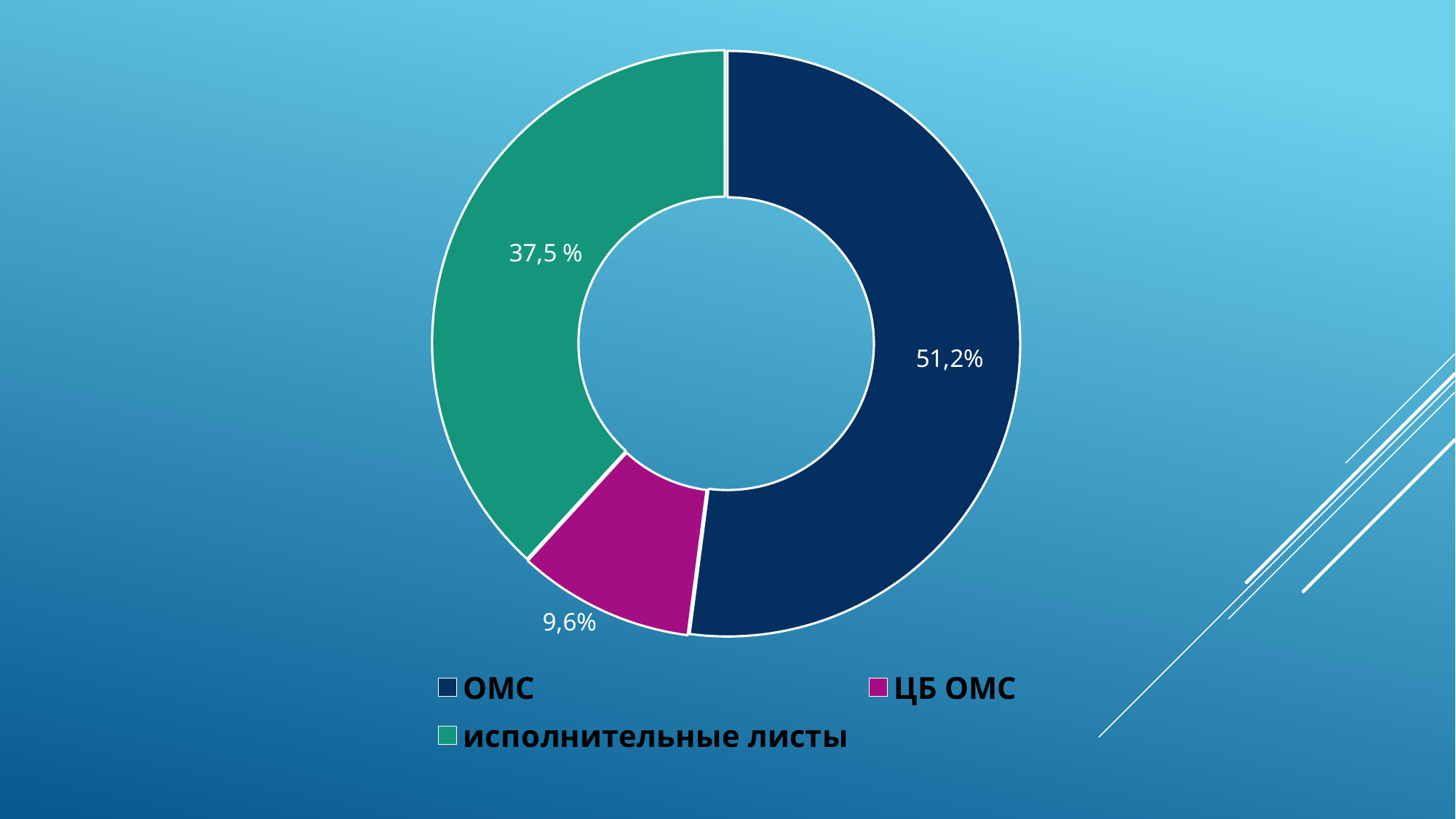
Which is larger, the share for ЦБ ОМС or for исполнительные листы? исполнительные листы What colour is the ЦБ ОМС slice? magenta Which category has the smallest share? ЦБ ОМС What share does the ЦБ ОМС slice have? 9,6% How many categories does the chart show? 3 What share does the ОМС slice have? 51,2% What is the difference in percentage points between the ОМС share and the исполнительные листы share? 13,7 Which is larger, the share for ОМС or for исполнительные листы? ОМС What is the difference in percentage points between the исполнительные листы share and the ЦБ ОМС share? 27,9 What kind of chart is shown on the slide? doughnut chart Which category has the largest share? ОМС What share does the исполнительные листы slice have? 37,5 %